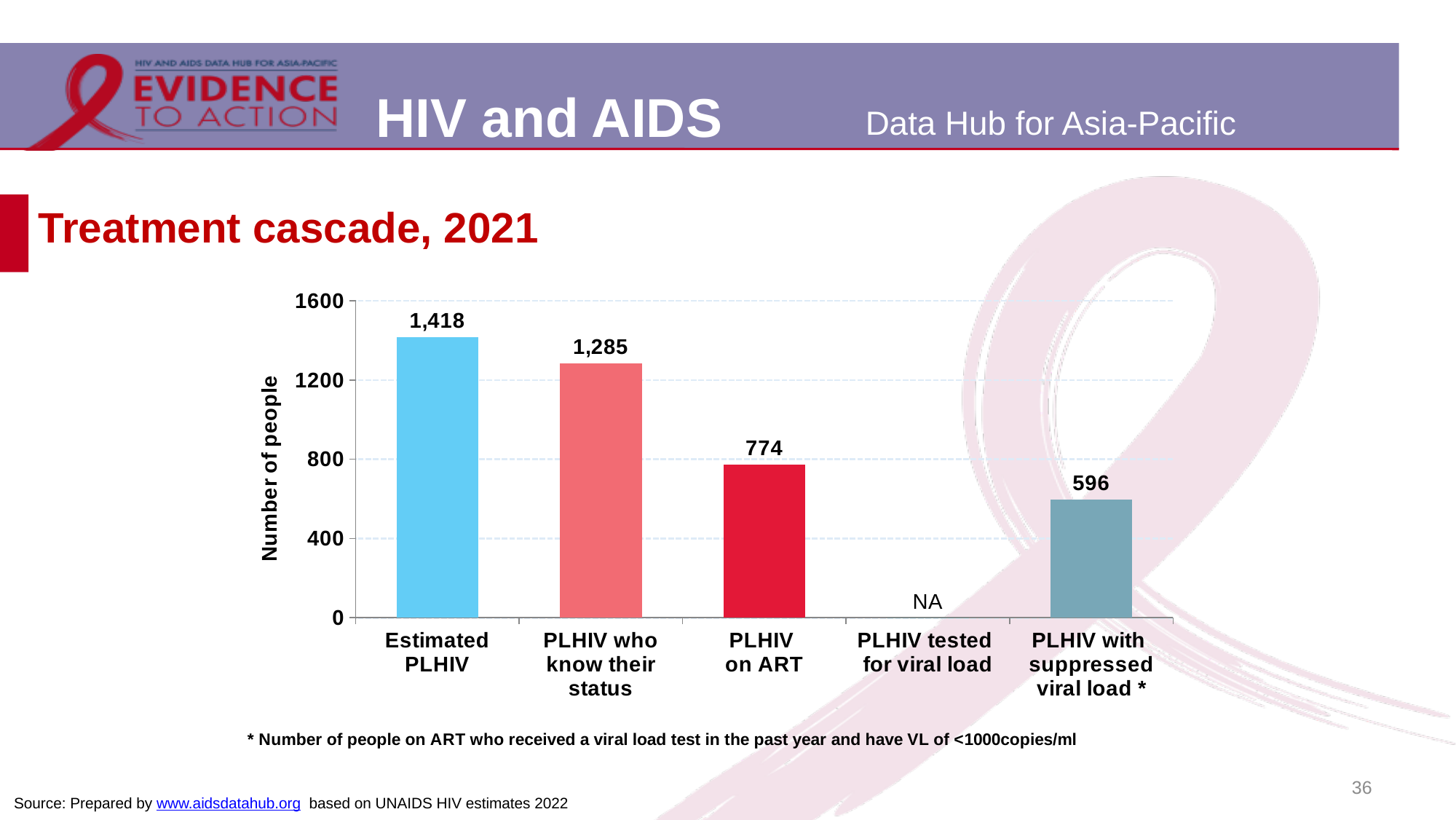
Which is larger, PLHIV on ART or PLHIV with suppressed viral load? PLHIV on ART What is the value for PLHIV who know their status? 1,285 Which category has the highest value? Estimated PLHIV What is the value for PLHIV on ART? 774 What is the value for PLHIV with suppressed viral load? 596 What is shown for PLHIV tested for viral load? NA What type of chart is this? Bar chart What is the difference between Estimated PLHIV and PLHIV who know their status? 133 Among the categories with a numeric value, which has the lowest value? PLHIV with suppressed viral load How many categories are shown on the x axis? 5 What is the difference between PLHIV on ART and PLHIV with suppressed viral load? 178 What is the value for Estimated PLHIV? 1,418